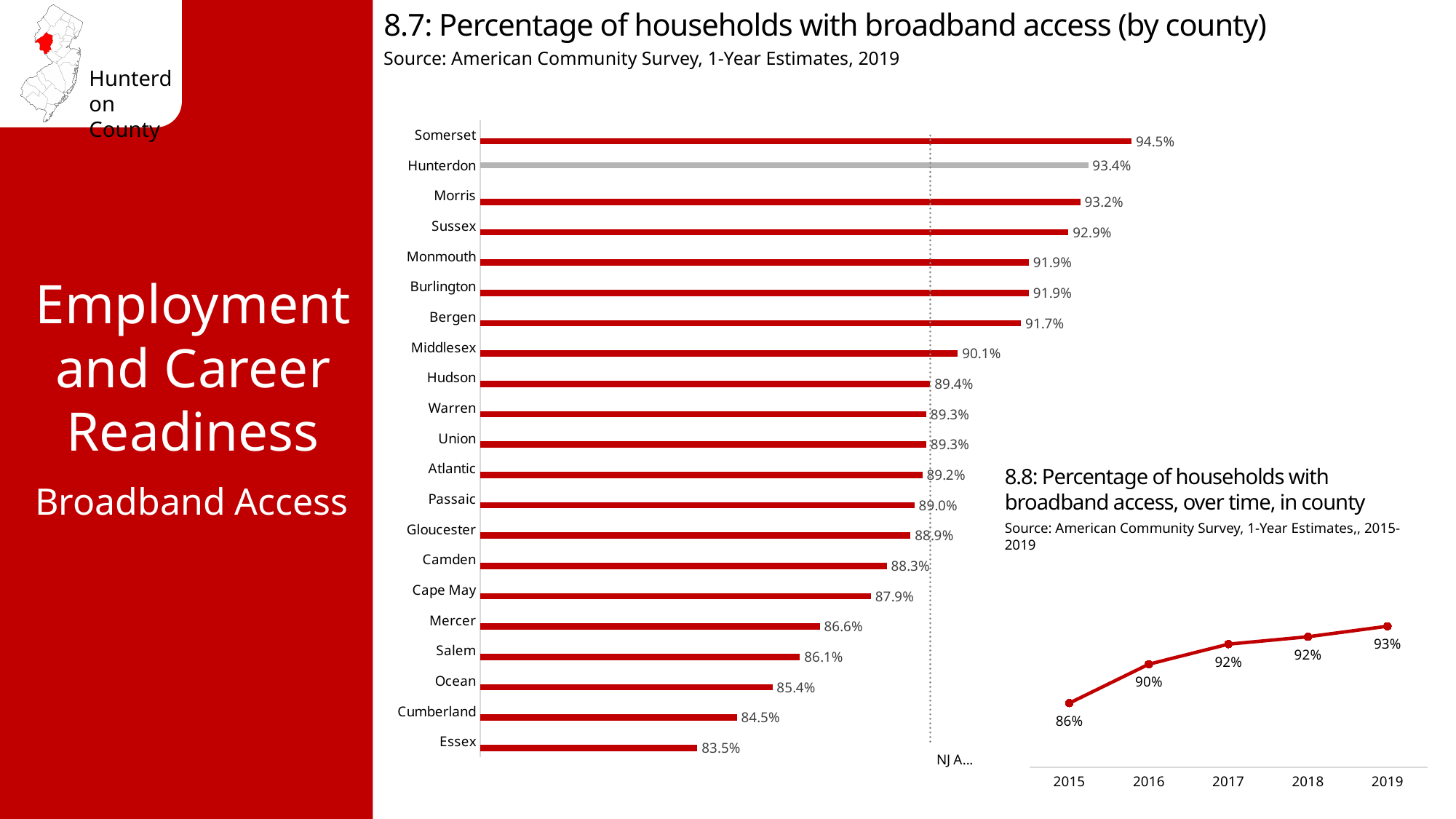
In chart 8.7, what is the difference between Somerset's value and Essex's value? 11.0% In chart 8.7, which has a higher value, Morris or Middlesex? Morris In chart 8.8 (Percentage of households with broadband access over time), what is the value for 2015? 86% In chart 8.8, do the values rise or fall from 2015 to 2019? Rise In chart 8.7, which county has the lowest percentage of households with broadband access? Essex In chart 8.7 (Percentage of households with broadband access by county), what is the value for Hunterdon? 93.4% What kind of chart is chart 8.7? Bar chart In chart 8.8, what is the value for 2019? 93% In chart 8.7, which county has the highest percentage of households with broadband access? Somerset In chart 8.7, how many counties are plotted? 21 In chart 8.8, how many years are plotted? 5 In chart 8.7, what is the value for Cumberland? 84.5%